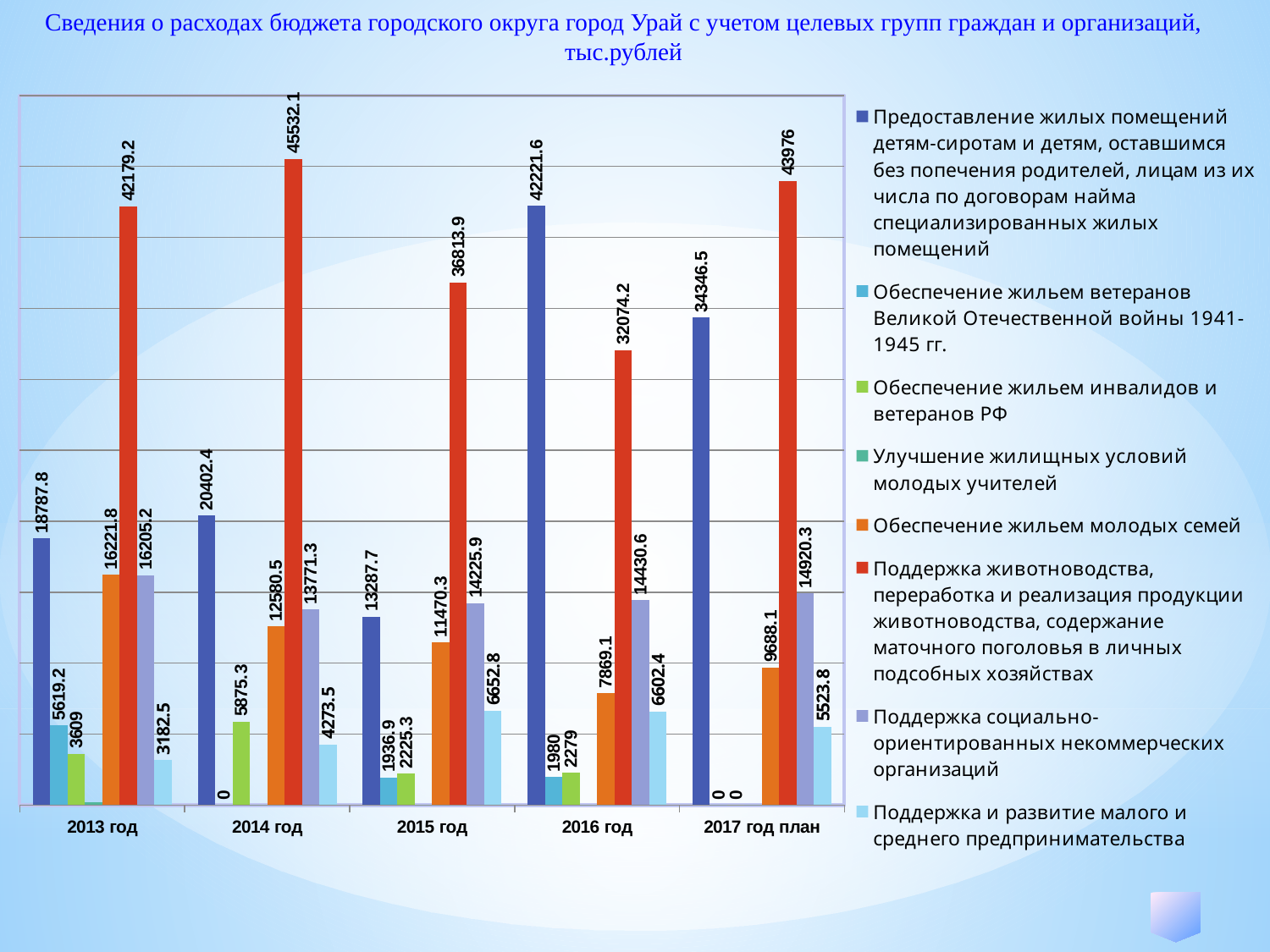
What kind of chart is shown on the slide? Bar chart In what units are the values on the chart expressed, according to the title? тыс.рублей What is the value for Поддержка и развитие малого и среднего предпринимательства in 2015 год? 6652.8 In which year is the value for Поддержка животноводства the highest? 2014 год What is the difference between the values for Предоставление жилых помещений детям-сиротам in 2016 год and 2013 год? 23433.8 What is the value for Предоставление жилых помещений детям-сиротам in 2016 год? 42221.6 Does the value for Обеспечение жильем молодых семей rise or fall from 2013 год to 2016 год? Fall What is the value for Поддержка животноводства, переработка и реализация продукции животноводства in 2014 год? 45532.1 How many series does the legend list? 8 How many year categories are shown on the x axis? 5 In which year is the value for Обеспечение жильем молодых семей the lowest? 2016 год In 2015 год, which is larger: Поддержка животноводства or Предоставление жилых помещений детям-сиротам? Поддержка животноводства